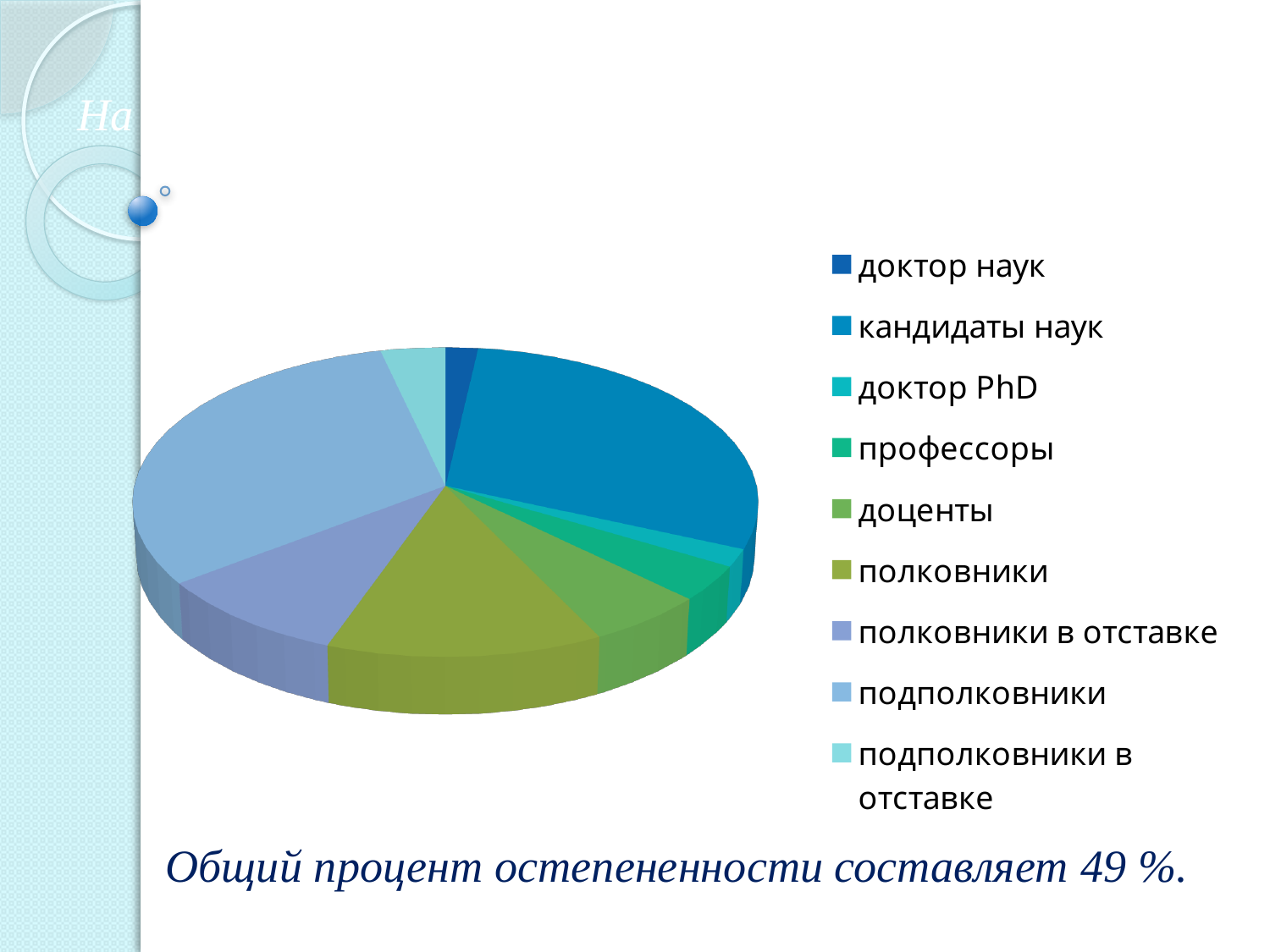
According to the text below the chart, what is the overall percentage of staff with academic degrees (общий процент остепененности)? 49 % How many categories does the pie chart's legend list? 9 Which category has the largest slice of the pie chart? подполковники Which slice is larger: доценты or подполковники в отставке? доценты Which slice is larger: подполковники or полковники в отставке? подполковники What is the first category listed in the pie chart's legend? доктор наук Which slice is larger: кандидаты наук or профессоры? кандидаты наук What kind of chart is shown on the slide? pie chart